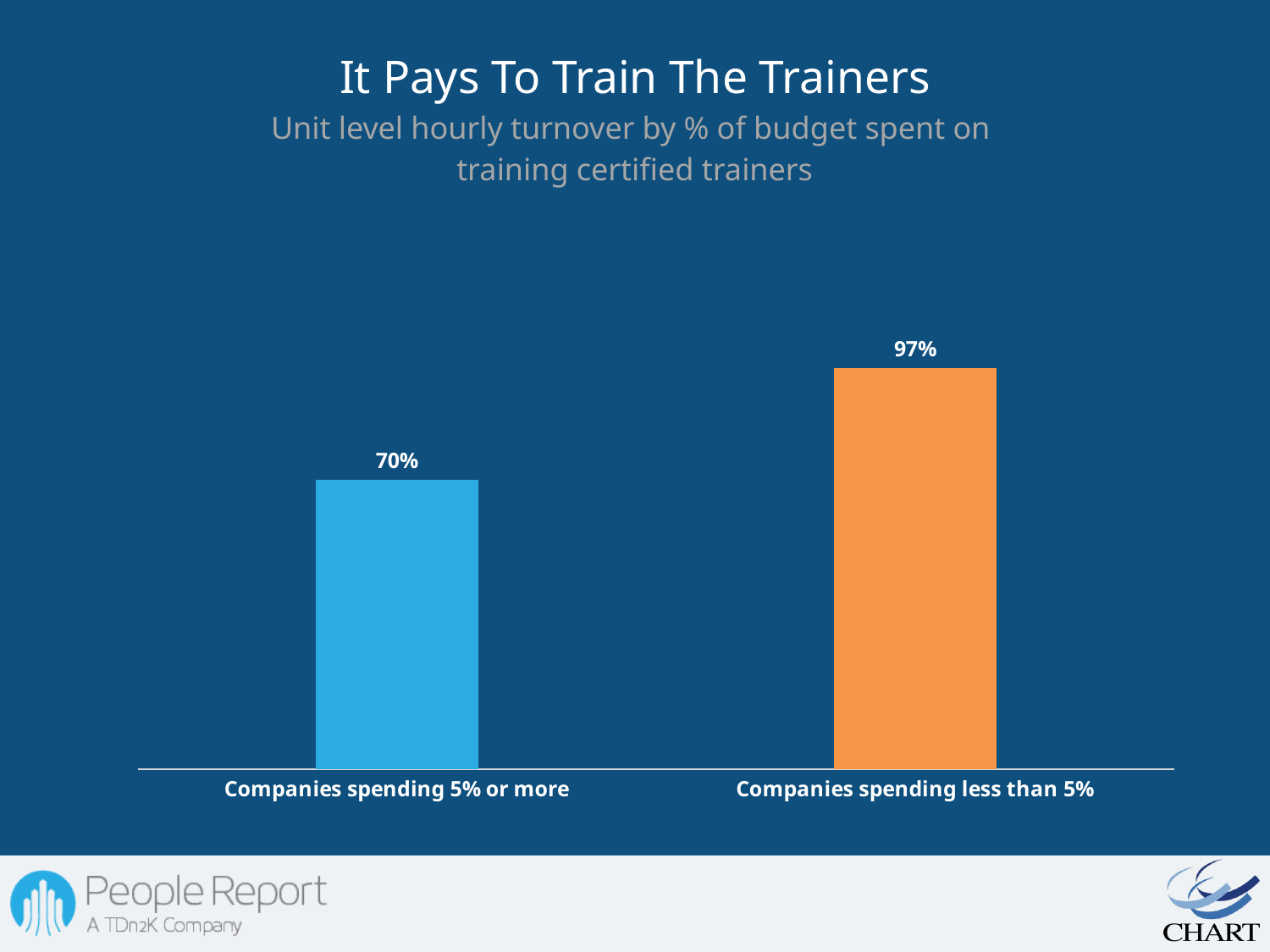
What is the unit level hourly turnover for companies spending less than 5%? 97% How many categories are shown in the chart? 2 What is the difference in turnover between companies spending less than 5% and companies spending 5% or more? 27% Is the turnover higher for companies spending 5% or more or for companies spending less than 5%? Companies spending less than 5% What colour is the bar for companies spending less than 5%? Orange What is the title of the slide? It Pays To Train The Trainers Which category has the lower turnover? Companies spending 5% or more What kind of chart is shown on the slide? Bar chart Which category has the higher turnover? Companies spending less than 5% What is the unit level hourly turnover for companies spending 5% or more? 70%